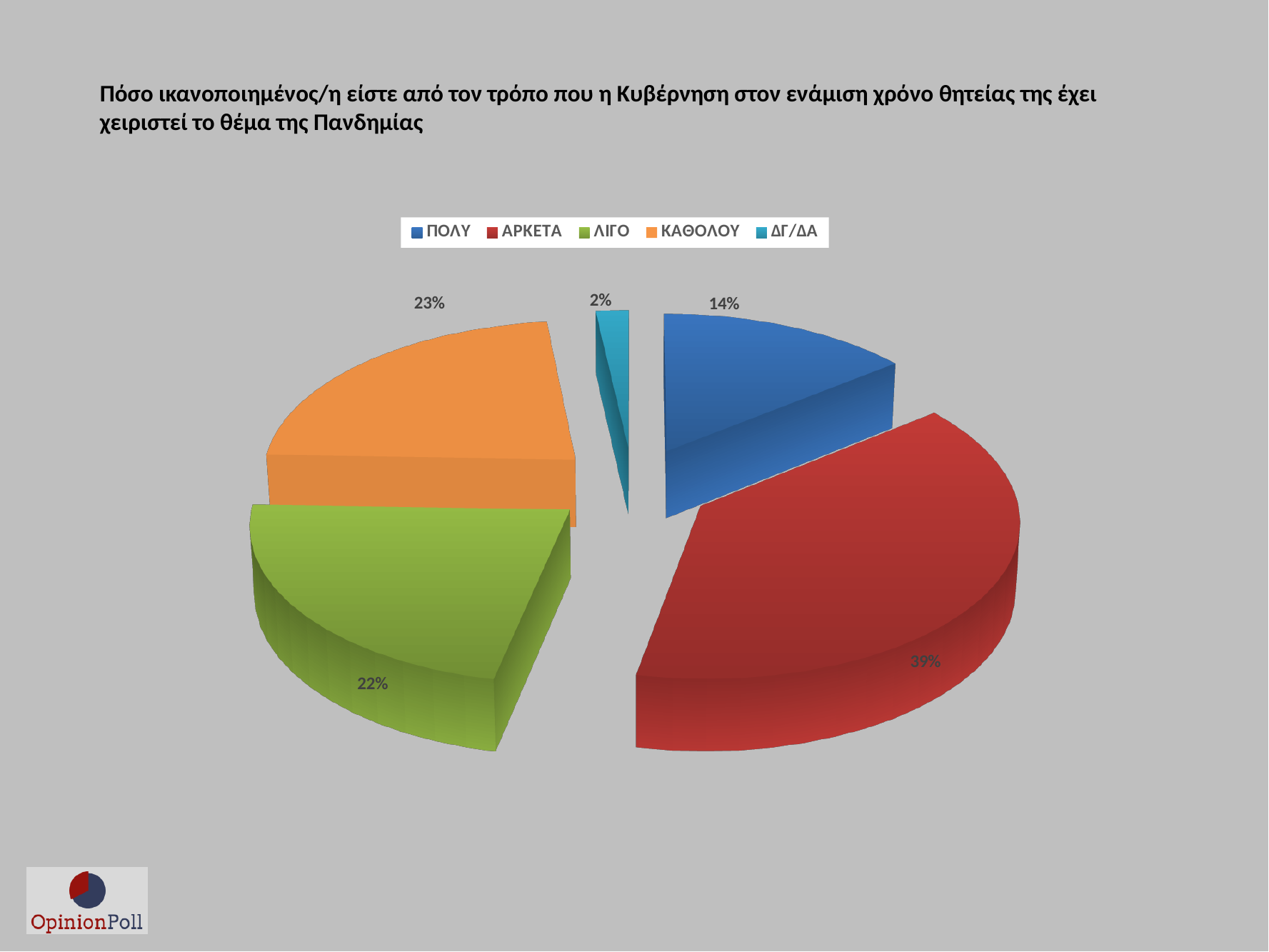
Which response has the smallest share of the pie? ΔΓ/ΔΑ What percentage of respondents answered ΠΟΛΥ? 14% Which response has the largest share of the pie? ΑΡΚΕΤΑ Which is larger, the share for ΚΑΘΟΛΟΥ or the share for ΠΟΛΥ? ΚΑΘΟΛΟΥ Which colour represents ΛΙΓΟ in the legend? green What is the difference in percentage points between ΑΡΚΕΤΑ and ΠΟΛΥ? 25 How many slices does the pie chart have? 5 What percentage of respondents answered ΚΑΘΟΛΟΥ? 23% What kind of chart is shown on the slide? pie chart What percentage of respondents answered ΛΙΓΟ? 22% What percentage of respondents answered ΔΓ/ΔΑ? 2% What percentage of respondents answered ΑΡΚΕΤΑ? 39%